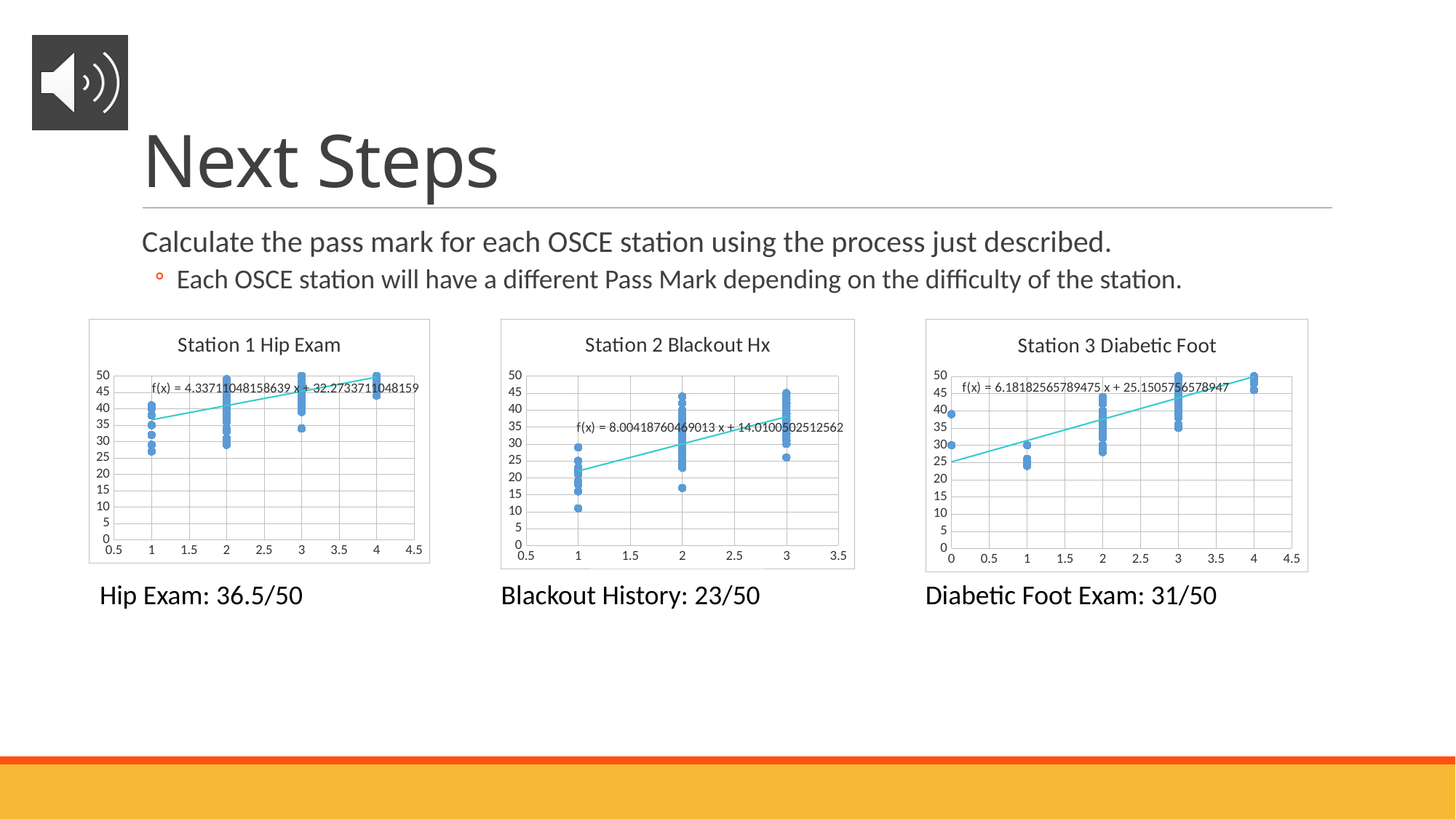
What is the maximum value shown on the y axis of 'Station 1 Hip Exam'? 50 In 'Station 2 Blackout Hx', is the lowest point at x = 1 greater or less than 15? less In 'Station 3 Diabetic Foot', is the lowest point at x = 1 greater or less than 30? less In 'Station 1 Hip Exam', are the points at x = 4 greater or less than 40? greater In 'Station 3 Diabetic Foot', does the trendline rise or fall as x increases? rises What trendline equation is printed on 'Station 3 Diabetic Foot'? f(x) = 6.18182565789475 x + 25.1505756578947 What kind of chart is 'Station 1 Hip Exam'? scatter chart In 'Station 2 Blackout Hx', does the trendline rise or fall as x increases? rises In 'Station 1 Hip Exam', does the trendline rise or fall as x increases? rises How many charts are shown on the slide? 3 In 'Station 2 Blackout Hx', are the points at x = 3 generally higher or lower than the points at x = 1? higher